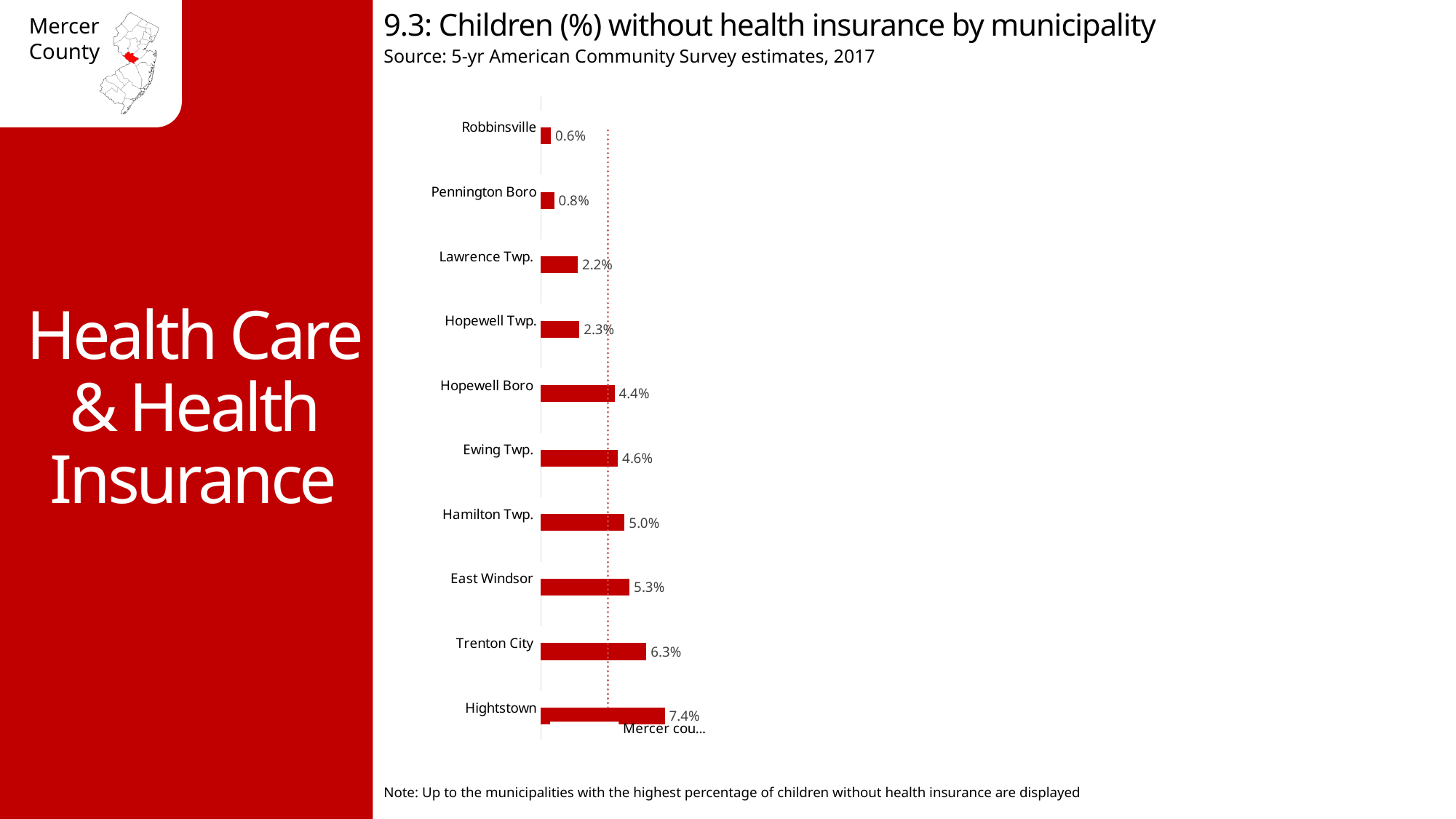
What is the value for Hamilton Twp.? 5.0% What is the source of the data shown in the chart? 5-yr American Community Survey estimates, 2017 What is the value shown for Trenton City? 6.3% What is the difference between the values for East Windsor and Hopewell Boro? 0.9% What percentage is shown for Robbinsville? 0.6% Which municipality has the highest percentage of children without health insurance? Hightstown What type of chart is used on this slide? Bar chart Which has a higher value, Ewing Twp. or Lawrence Twp.? Ewing Twp. What percentage of children are without health insurance in Hightstown? 7.4% How many municipalities are shown as bars in the chart? 10 Which municipality has the lowest percentage of children without health insurance? Robbinsville What is the difference between the values for Hightstown and Trenton City? 1.1%